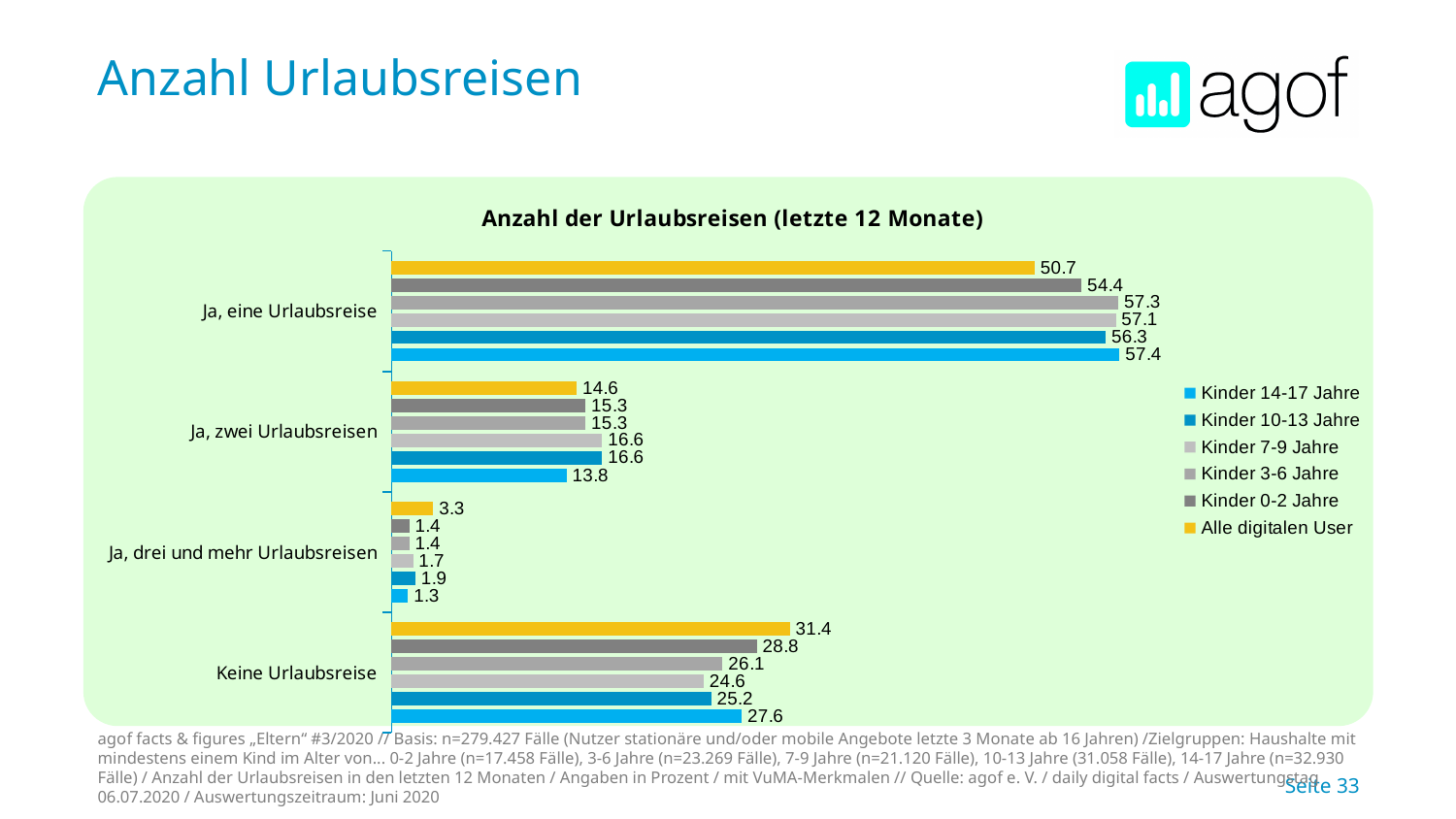
What is the value for Kinder 7-9 Jahre in the category Ja, zwei Urlaubsreisen? 16.6 What type of chart is shown on the slide? bar chart Which series has the highest value in the category Keine Urlaubsreise? Alle digitalen User What is the difference between Alle digitalen User and Kinder 0-2 Jahre in the category Keine Urlaubsreise? 2.6 How many categories are shown on the vertical axis? 4 What is the value for Alle digitalen User in the category Ja, eine Urlaubsreise? 50.7 What is the value for Kinder 3-6 Jahre in the category Ja, eine Urlaubsreise? 57.3 How many series does the legend list? 6 Which series has the lowest value in the category Ja, drei und mehr Urlaubsreisen? Kinder 14-17 Jahre What is the title of the chart? Anzahl der Urlaubsreisen (letzte 12 Monate) What is the value for Kinder 14-17 Jahre in the category Keine Urlaubsreise? 27.6 In the category Ja, zwei Urlaubsreisen, which is larger: Kinder 10-13 Jahre or Kinder 14-17 Jahre? Kinder 10-13 Jahre